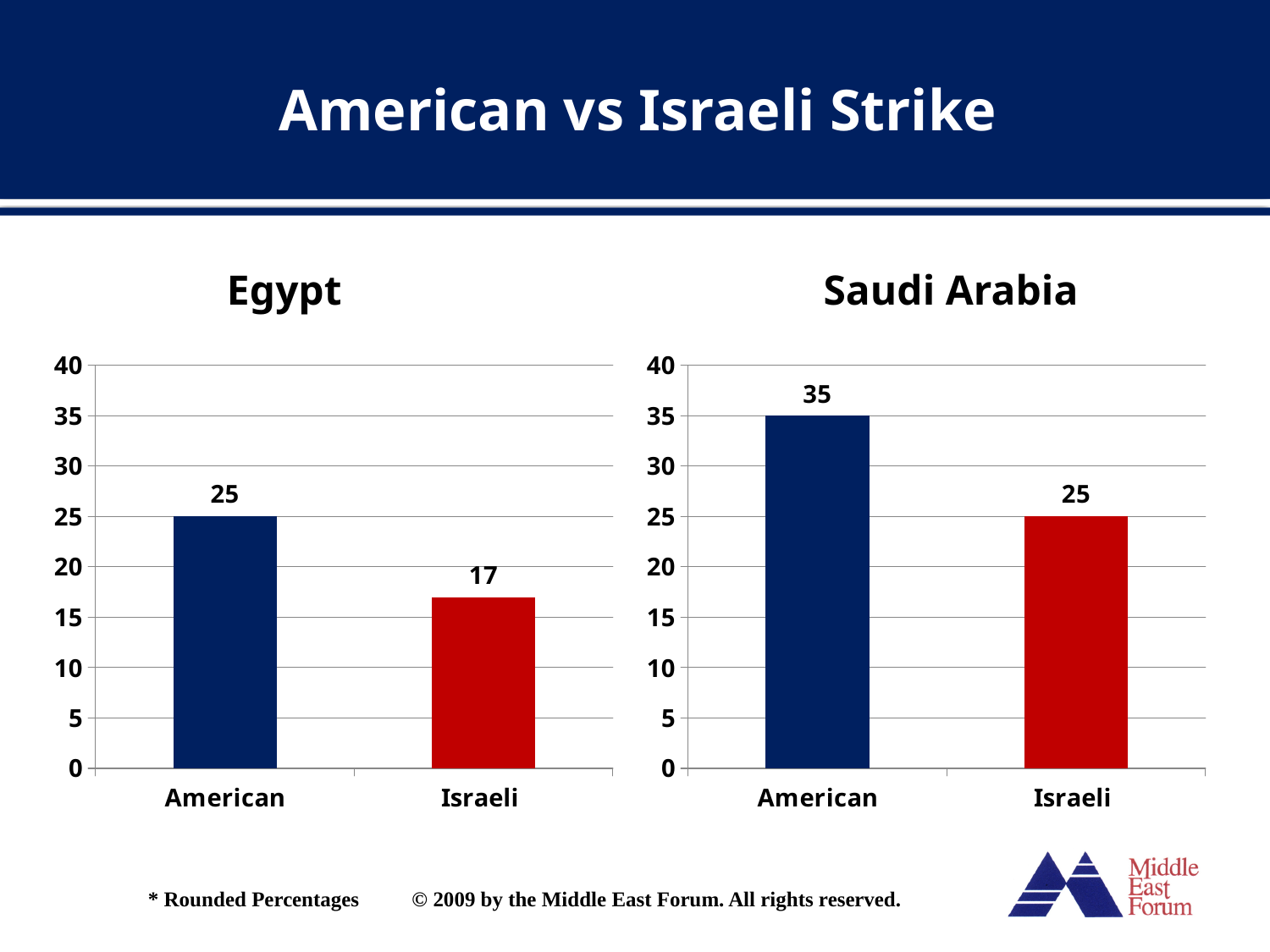
In the Saudi Arabia chart, is the value for American greater or less than 30? greater In the Saudi Arabia chart, what is the value for Israeli? 25 In the Saudi Arabia chart, which category has the lowest value? Israeli What kind of chart is the Saudi Arabia chart? Bar chart In the Egypt chart, what is the difference between the American and Israeli values? 8 In the Saudi Arabia chart, what is the difference between the American and Israeli values? 10 What is the title of the chart on the left side of the slide? Egypt In the Saudi Arabia chart, what is the value for American? 35 In the Egypt chart, what is the value for American? 25 In the Egypt chart, how many categories are shown on the x axis? 2 In the Egypt chart, which category has the highest value? American In the Egypt chart, what is the value for Israeli? 17